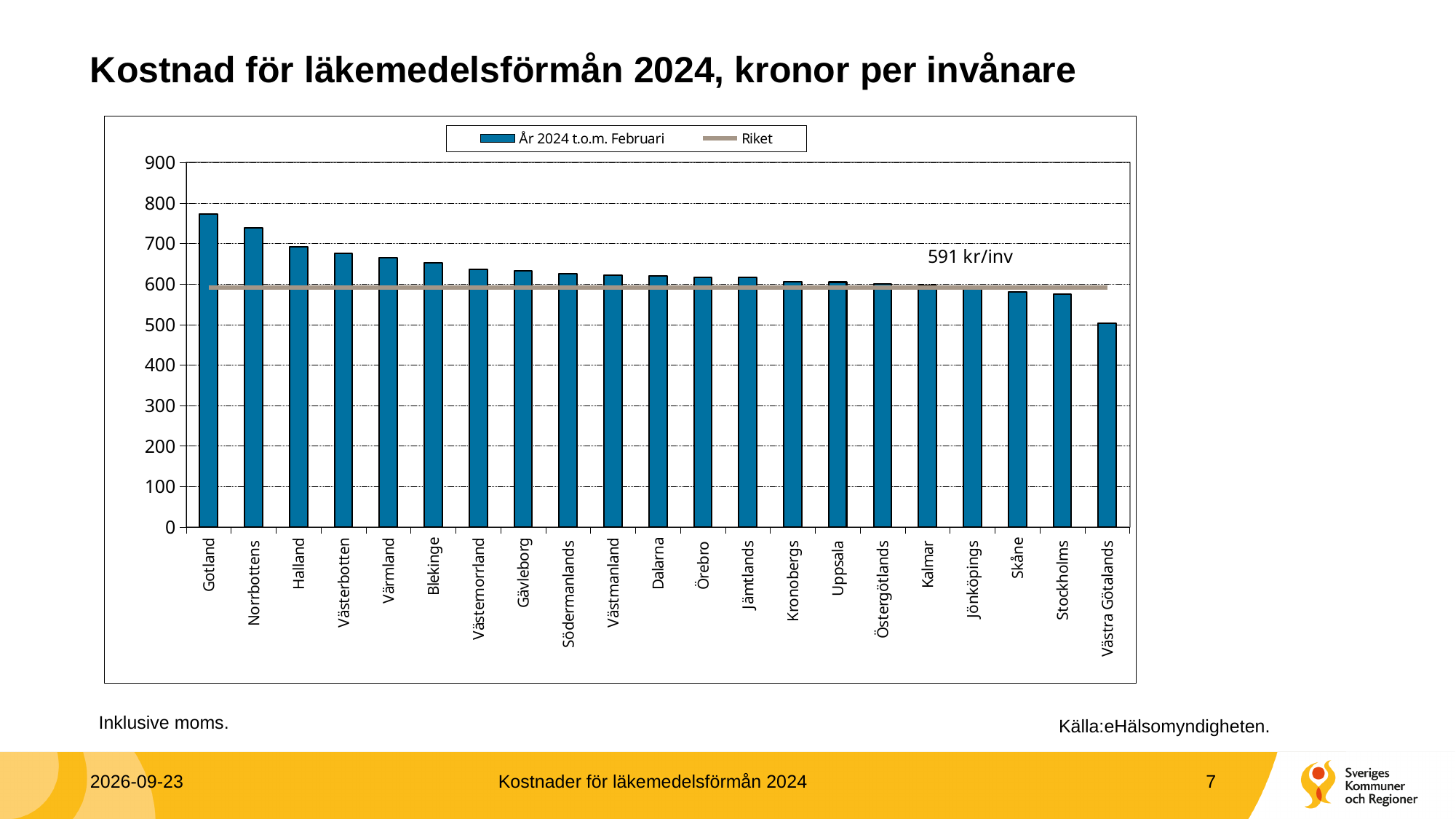
Which region has the lowest cost for läkemedelsförmån per invånare? Västra Götalands Is the value for Stockholms greater or less than 600? less Is the value for Västra Götalands greater or less than 600? less Which region has the highest cost for läkemedelsförmån per invånare? Gotland Which is larger, the value for Gotland or the value for Norrbottens? Gotland How many series does the legend list? 2 What value is given for Riket (the national level line)? 591 kr/inv What kind of chart is shown on the slide? Combination bar and line chart How many regions are shown on the x axis? 21 What are the two entries in the chart legend? År 2024 t.o.m. Februari and Riket Is the value for Gotland greater or less than 700? greater Do the bar values rise or fall from left to right along the x axis? Fall